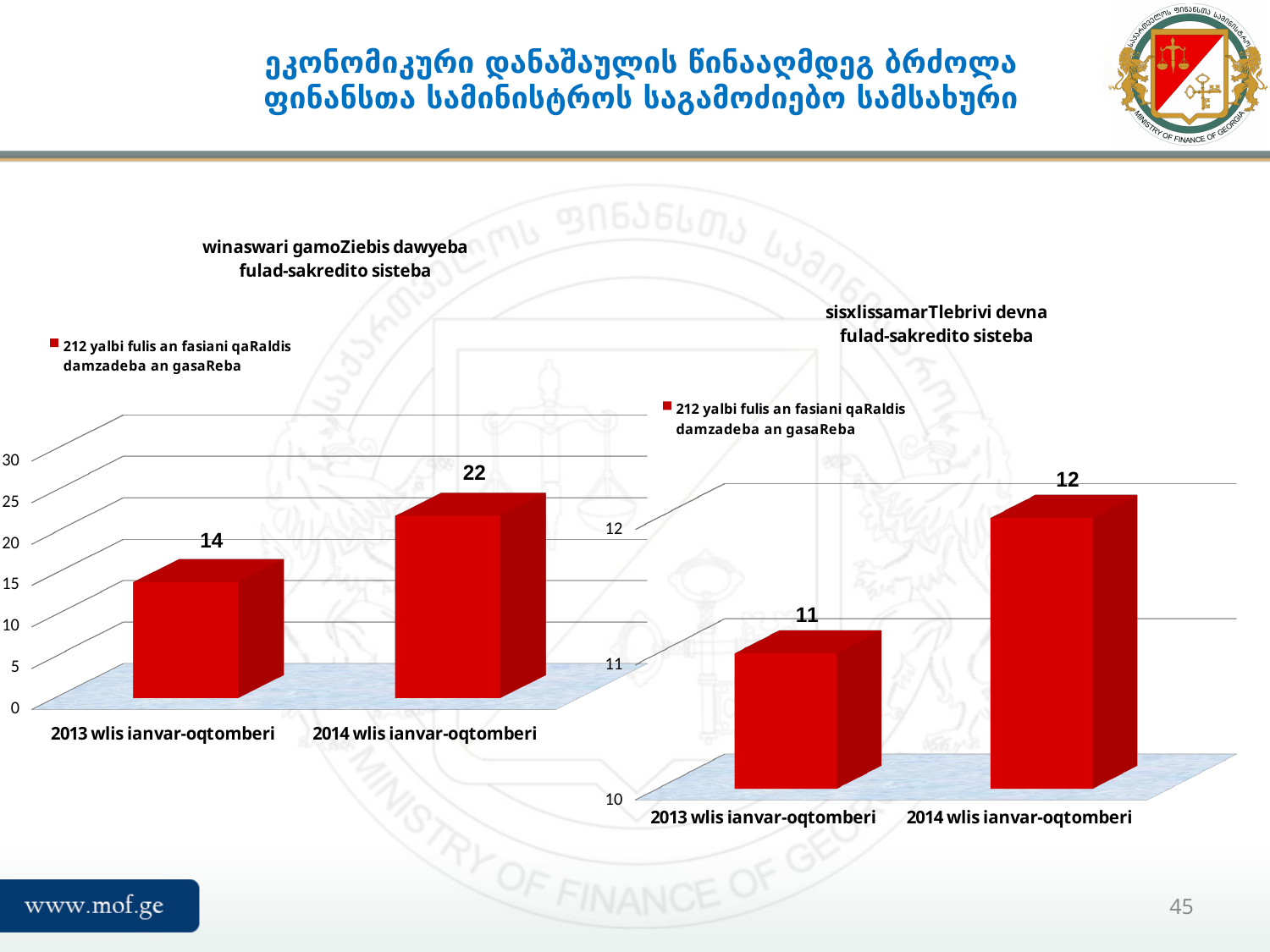
In the right chart (sisxlissamarTlebrivi devna), what is the difference between the 2014 and 2013 values? 1 How many series does the legend of the left chart (winaswari gamoZiebis dawyeba) list? 1 In the right chart (sisxlissamarTlebrivi devna), what is the value for 2013 wlis ianvar-oqtomberi? 11 In the left chart (winaswari gamoZiebis dawyeba), what is the value for 2014 wlis ianvar-oqtomberi? 22 What type of chart is the right chart (sisxlissamarTlebrivi devna)? bar chart In the left chart (winaswari gamoZiebis dawyeba), what is the value for 2013 wlis ianvar-oqtomberi? 14 In the right chart (sisxlissamarTlebrivi devna), which period has the lower value? 2013 wlis ianvar-oqtomberi In the left chart (winaswari gamoZiebis dawyeba), what is the difference between the 2014 and 2013 values? 8 In the left chart (winaswari gamoZiebis dawyeba), is the value for 2014 wlis ianvar-oqtomberi greater or less than 20? greater In the right chart (sisxlissamarTlebrivi devna), what is the value for 2014 wlis ianvar-oqtomberi? 12 In the left chart (winaswari gamoZiebis dawyeba), which period has the higher value? 2014 wlis ianvar-oqtomberi How many categories are shown on the x axis of the left chart (winaswari gamoZiebis dawyeba)? 2